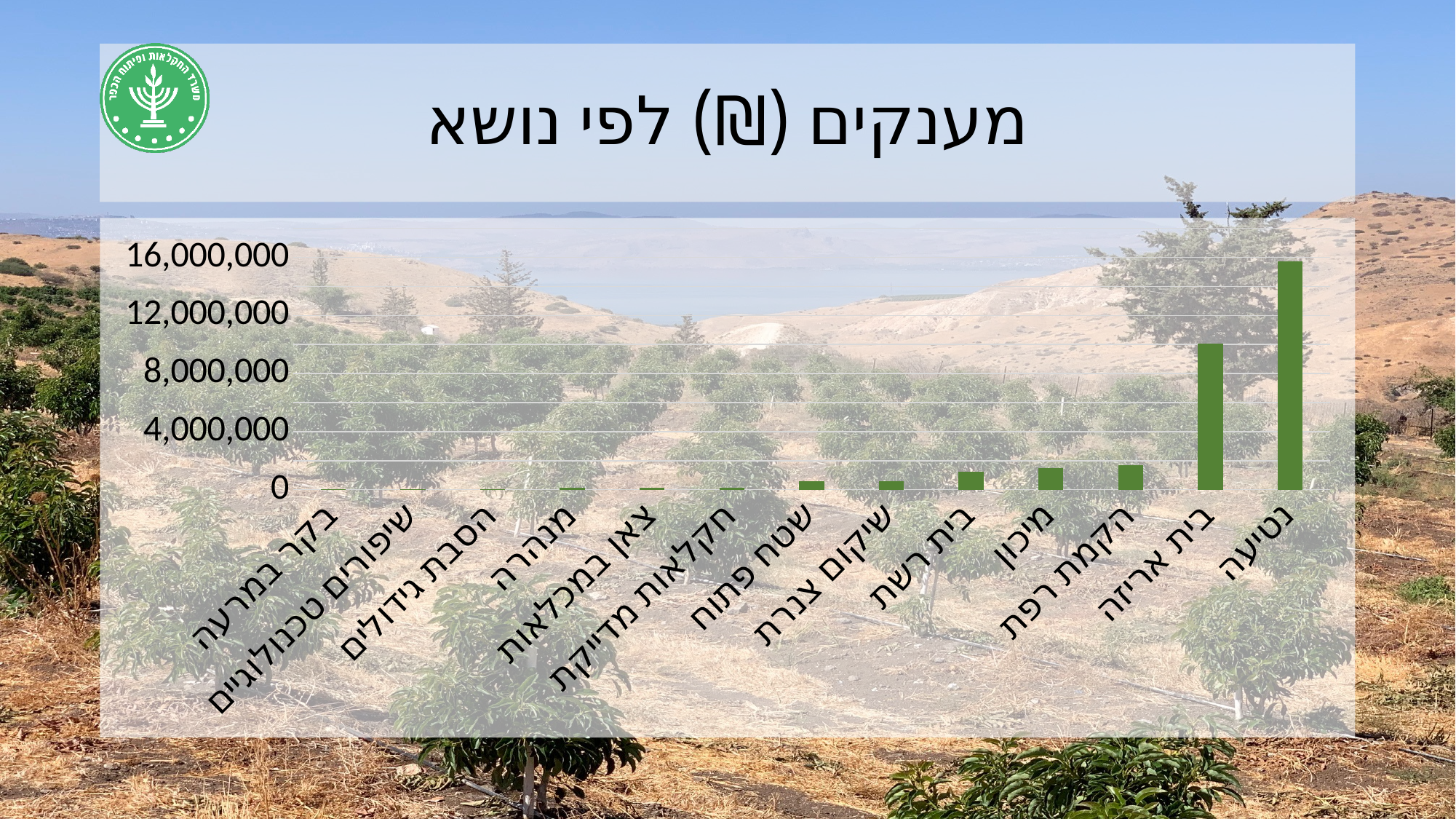
Is the value for בית אריזה greater or less than 12,000,000? less Is the value for נטיעה greater or less than 12,000,000? greater Which category has the highest value in the chart? נטיעה What is the title of the chart? מענקים (₪) לפי נושא Is the value for מיכון greater or less than 4,000,000? less What kind of chart is shown on the slide? Bar chart Which is larger, the value for נטיעה or the value for בית אריזה? נטיעה How many categories are shown on the x axis of the chart? 13 Which is larger, the value for בית אריזה or the value for הקמת רפת? בית אריזה Do the values generally rise or fall moving from left to right along the x axis? rise